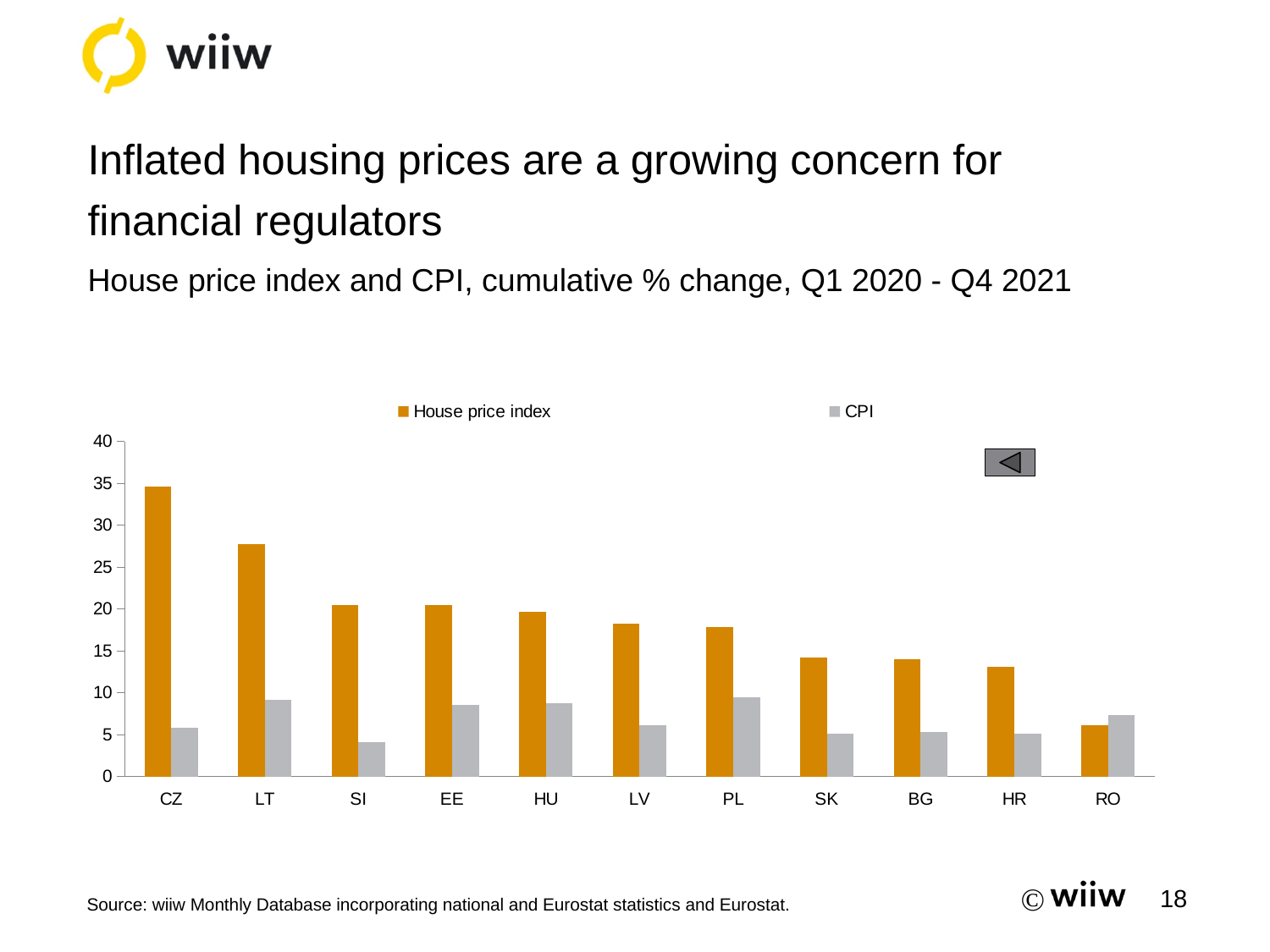
What colour are the House price index bars? orange Which country has the highest House price index value? CZ Is the House price index value for CZ greater or less than 30? greater For RO, which is larger: the House price index or the CPI? CPI How many countries are shown on the x axis? 11 Do the House price index values generally rise or fall from left to right across the x axis? fall Is the House price index value for HR greater or less than 15? less How many series does the legend list? 2 Which country has the lowest CPI value? SI What kind of chart is shown on the slide? bar chart Is the CPI value for LT greater or less than 10? less Which country has the lowest House price index value? RO